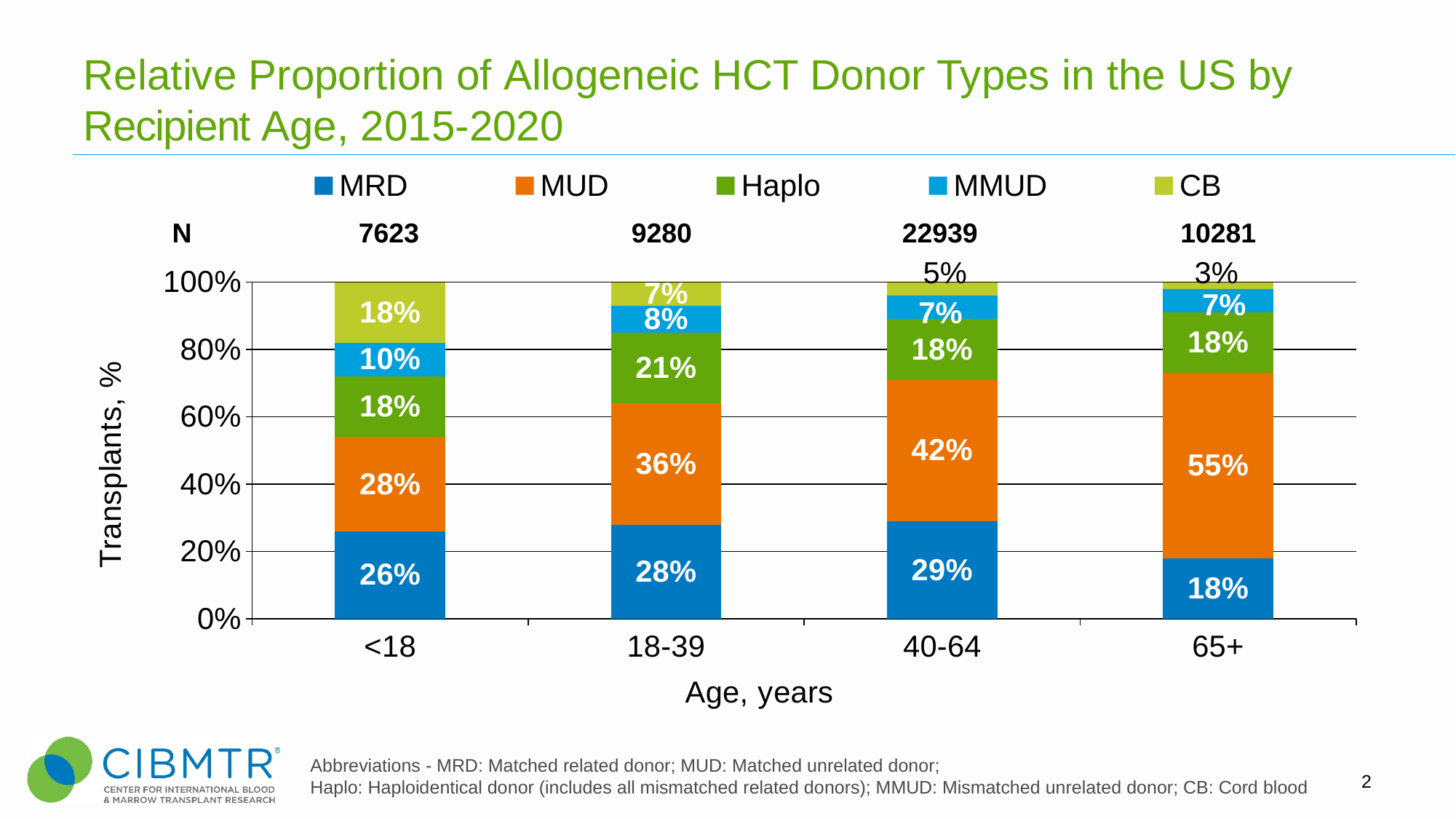
What is the MRD share for recipients aged 40-64? 29% What kind of chart is shown on the slide? Stacked bar chart What is the difference between the MUD percentage for 65+ and the MUD percentage for <18? 27% Which age group has the lowest CB percentage? 65+ What is the N value shown above the 40-64 age group? 22939 How many donor types does the legend list? 5 How many age groups are shown on the x axis? 4 What percentage of transplants in the 65+ age group were from MUD donors? 55% Is the MRD percentage larger for the 18-39 group or the 65+ group? 18-39 What is the Haplo percentage for the 18-39 age group? 21% What percentage of transplants in the <18 age group were cord blood (CB)? 18% Which age group has the highest MUD percentage? 65+